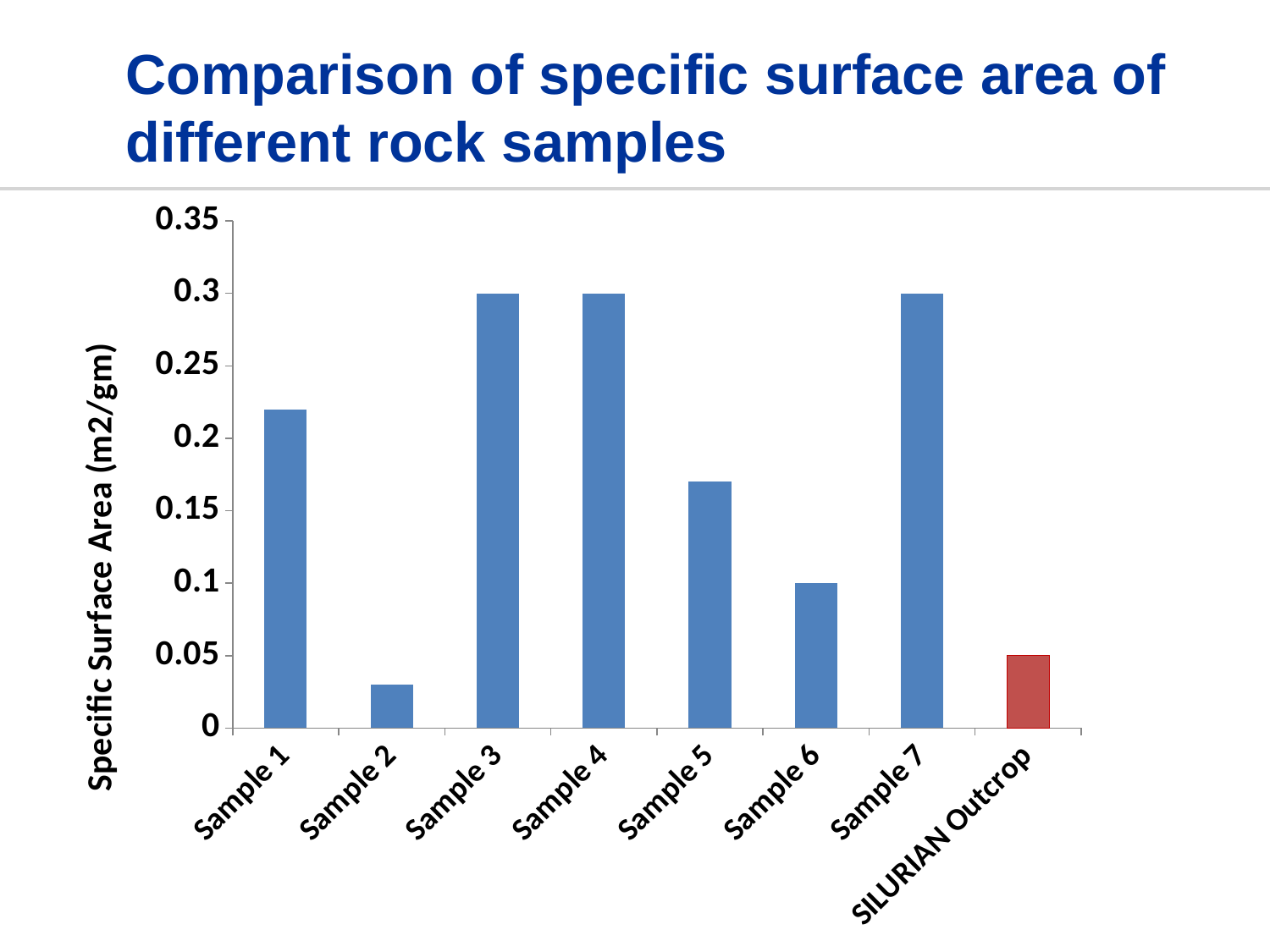
Which sample has the lowest specific surface area? Sample 2 What is the difference in specific surface area between Sample 3 and Sample 6? 0.2 Which has a larger specific surface area, Sample 6 or SILURIAN Outcrop? Sample 6 Is the value for Sample 1 greater or less than 0.2? greater What is the label of the vertical axis? Specific Surface Area (m2/gm) What is the specific surface area of the SILURIAN Outcrop sample? 0.05 What is the specific surface area of Sample 6? 0.1 What is the specific surface area of Sample 3? 0.3 Which has a larger specific surface area, Sample 1 or Sample 5? Sample 1 Is the value for Sample 5 greater or less than 0.15? greater How many rock samples are shown on the chart? 8 What kind of chart is shown on the slide? Bar chart